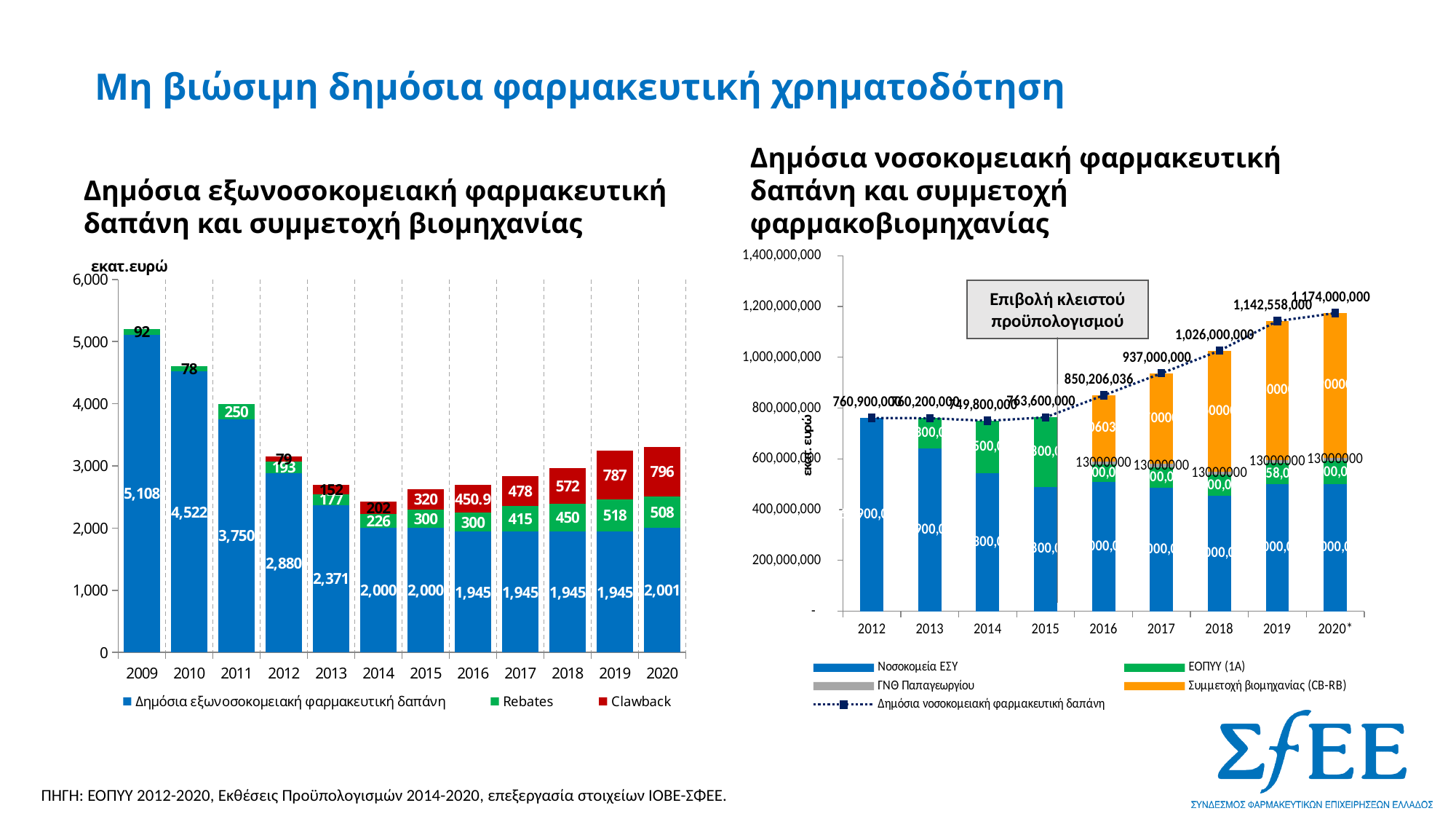
In the left chart, does the Δημόσια εξωνοσοκομειακή φαρμακευτική δαπάνη series rise or fall from 2009 to 2014? Fall In the left chart, what is the Rebates value for 2011? 250 What kind of chart is the left chart, 'Δημόσια εξωνοσοκομειακή φαρμακευτική δαπάνη και συμμετοχή βιομηχανίας'? Stacked bar chart In the left chart, what is the Clawback value for 2019? 787 In the left chart, how many series does the legend list? 3 In the left chart, what is the total of the stacked bar for 2020? 3,305 In the right chart, how many series does the legend list? 5 In the left chart, how many years are shown on the x axis? 12 In the right chart, is the Δημόσια νοσοκομειακή φαρμακευτική δαπάνη value for 2012 greater or less than 800,000,000? less In the left chart, what is the difference between the Δημόσια εξωνοσοκομειακή φαρμακευτική δαπάνη values for 2009 and 2010? 586 In the right chart, which year has the highest Δημόσια νοσοκομειακή φαρμακευτική δαπάνη value? 2020* In the right chart, what is the Δημόσια νοσοκομειακή φαρμακευτική δαπάνη value for 2017? 937,000,000